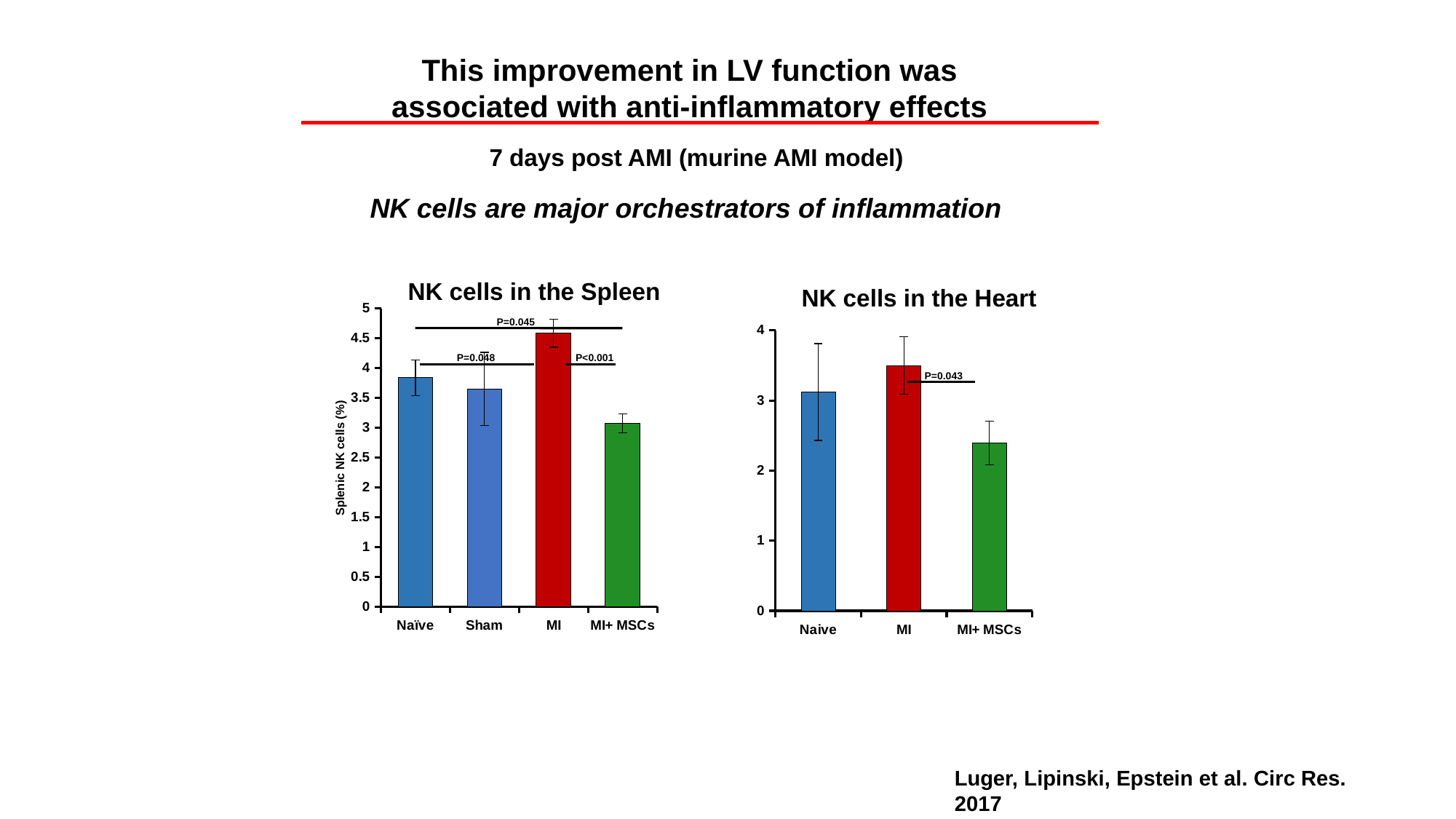
In the "NK cells in the Heart" chart, which category has the highest bar? MI What is the y-axis label of the "NK cells in the Spleen" chart? Splenic NK cells (%) What kind of chart is "NK cells in the Spleen"? bar chart In the "NK cells in the Spleen" chart, is the value for MI greater or less than 4.5? greater In the "NK cells in the Heart" chart, which bar is taller, Naive or MI? MI How many categories are shown on the x axis of the "NK cells in the Spleen" chart? 4 How many categories are shown on the x axis of the "NK cells in the Heart" chart? 3 What P value is shown between MI and MI+ MSCs in the "NK cells in the Heart" chart? P=0.043 In the "NK cells in the Heart" chart, is the value for MI+ MSCs greater or less than 3? less In the "NK cells in the Spleen" chart, which category has the lowest bar? MI+ MSCs In the "NK cells in the Spleen" chart, which category has the highest bar? MI In the "NK cells in the Heart" chart, which category has the lowest bar? MI+ MSCs